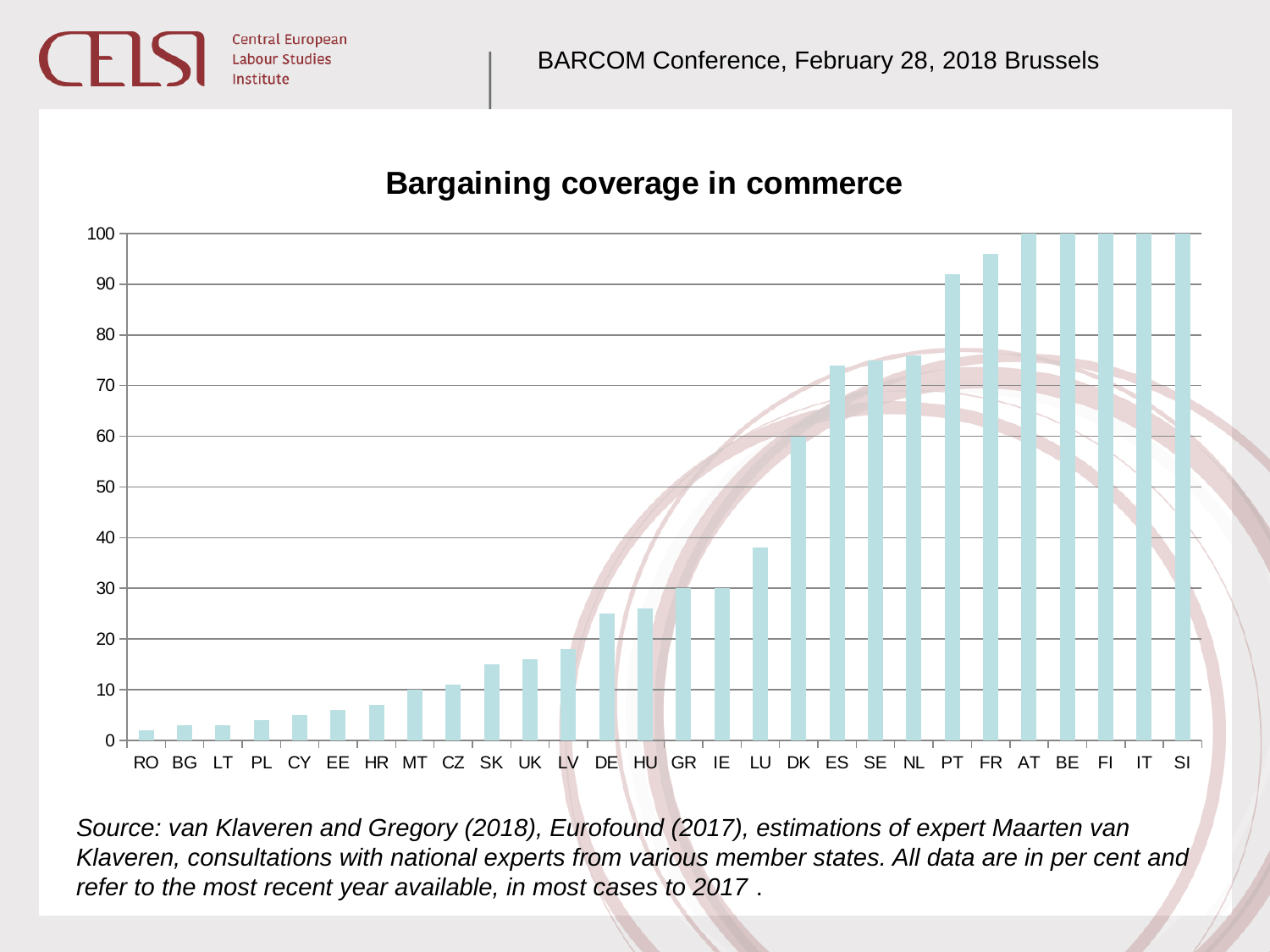
Is the value for ES greater or less than 70? greater What is the bargaining coverage value for DK? 60 Which has the larger value, DK or LU? DK Is the value for DE greater or less than 30? less How many countries are shown on the x axis of the chart? 28 What is the bargaining coverage value for GR? 30 What is the difference between the values for DK and GR? 30 Do the values rise or fall moving from left to right along the x axis? rise Which country has the lowest bargaining coverage in commerce? RO What kind of chart is shown on the slide? bar chart What is the bargaining coverage value for SI? 100 What is the title of the chart? Bargaining coverage in commerce